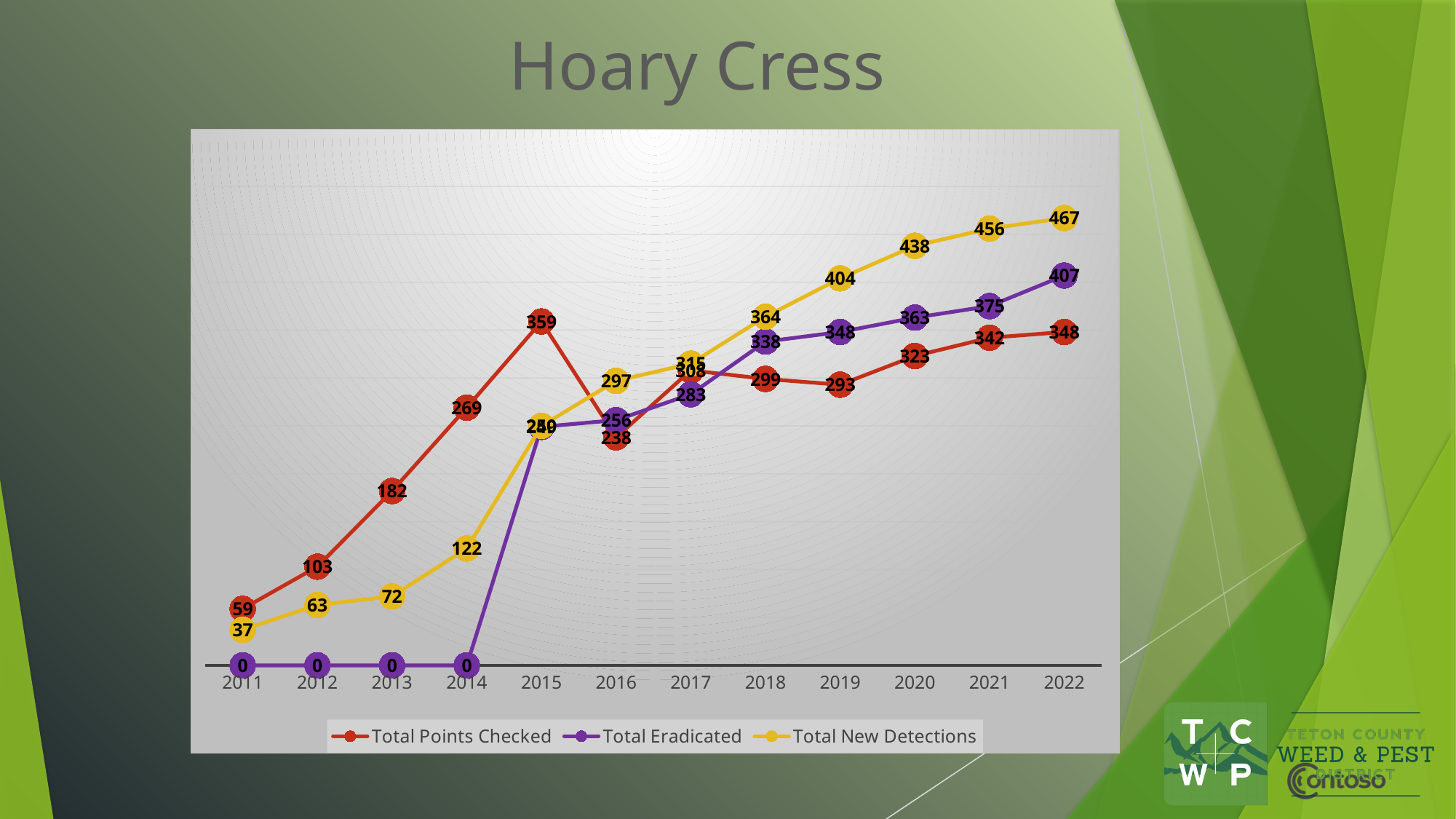
What is the title of the slide? Hoary Cress What is the difference between Total New Detections and Total Eradicated in 2022? 60 How many series does the legend list? 3 In which year is Total Points Checked highest? 2015 What is the value of Total New Detections in 2022? 467 What is the value of Total Points Checked in 2015? 359 In 2019, which is larger: Total Eradicated or Total Points Checked? Total Eradicated What kind of chart is shown on the slide? line chart How many years are plotted along the x axis? 12 What is the value of Total Eradicated in 2018? 338 What is the value of Total Eradicated in 2011? 0 Does Total New Detections rise or fall from 2016 to 2022? rise